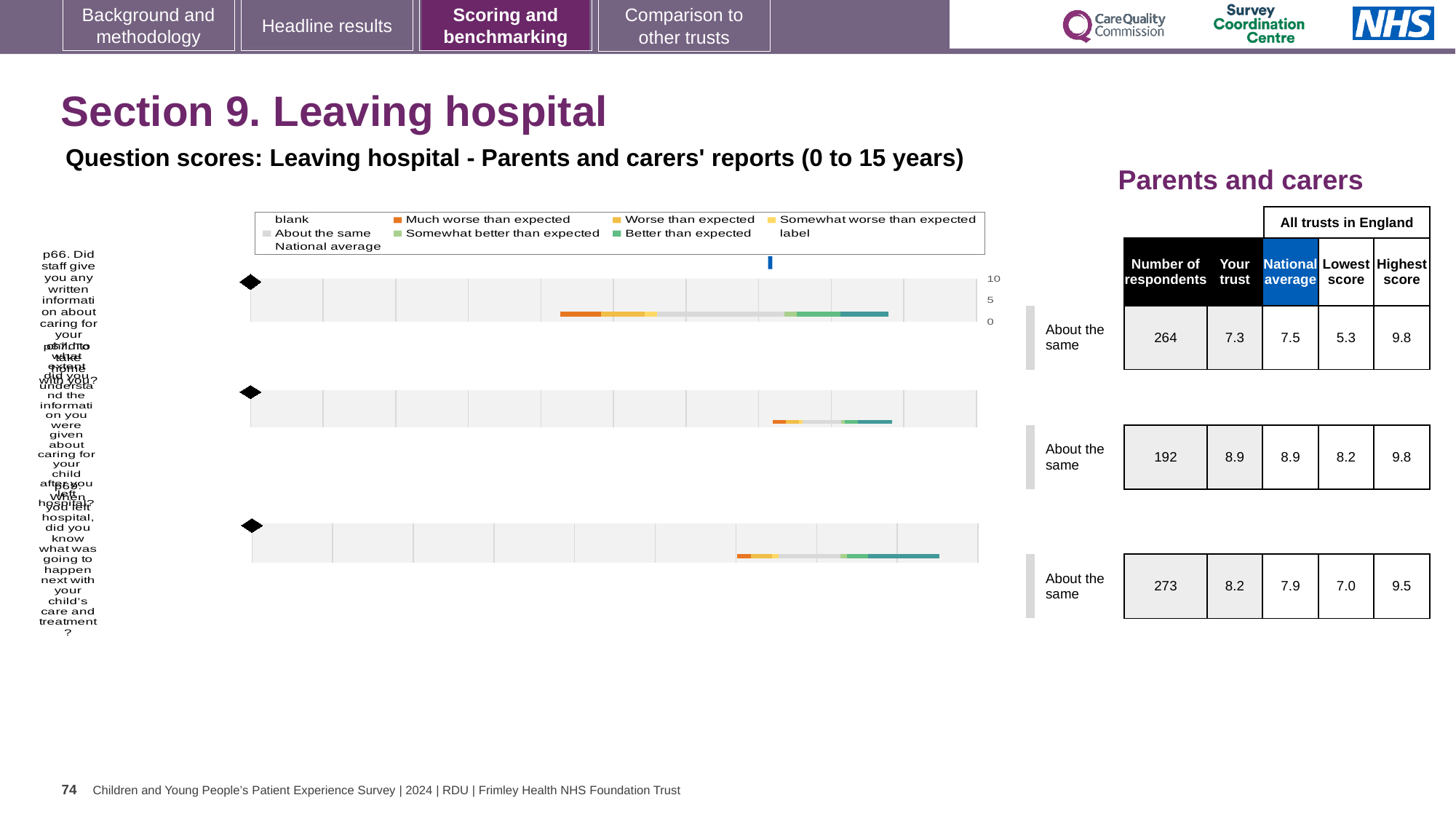
What kind of chart is used on this slide to show the question scores? bar chart Which legend entry is shown in orange? Much worse than expected What benchmark category label is shown to the left of the table for each of the three charts? About the same How many entries does the legend above the charts list? 9 Which chart's table row has the larger 'Your trust' score, the top chart or the bottom chart? bottom chart In the table beside the middle chart, what is the 'Number of respondents'? 192 In the table beside the top chart, what is the 'Your trust' score? 7.3 In the table beside the bottom chart, what is the 'National average' score? 7.9 How many separate benchmark charts are shown on the slide? 3 What is the highest tick value shown on the axis to the right of the top chart? 10 What is the difference between the 'Your trust' score and the 'National average' score in the table beside the bottom chart? 0.3 In the table beside the bottom chart, what is the 'Highest score'? 9.5